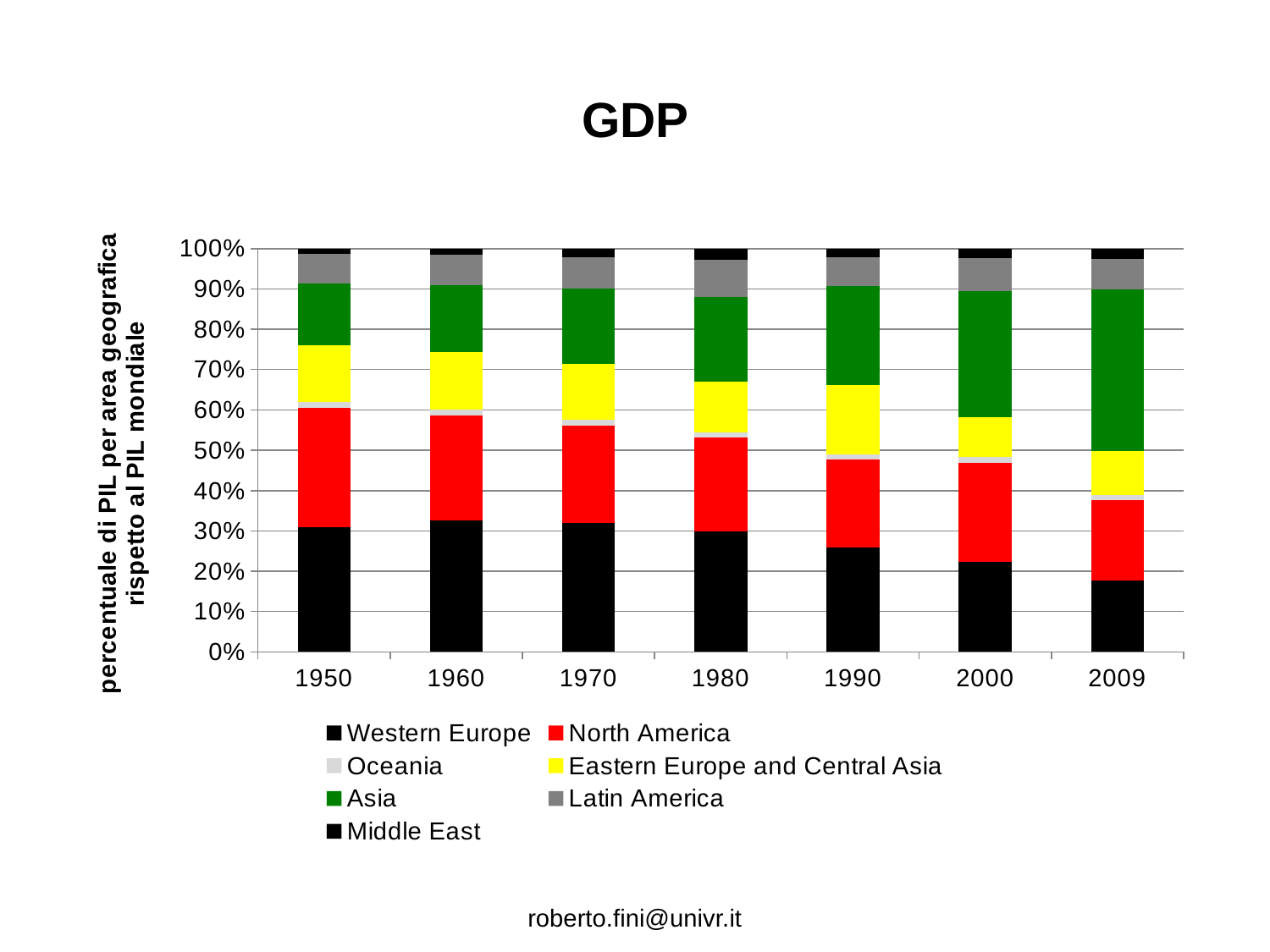
In which year is the Western Europe segment the smallest? 2009 Does the Western Europe share of GDP rise or fall from 1950 to 2009? fall Does the Western Europe segment for 2000 reach above or below 30%? below Which series is shown in green in the legend? Asia Does the Asia share of GDP rise or fall from 1950 to 2009? rise Does the Western Europe segment for 2009 reach above or below 20%? below How many series does the legend list? 7 What kind of chart is shown on the slide? stacked bar chart Does the Western Europe segment for 1990 reach above or below 30%? below What is the title of the chart? GDP How many years are shown along the x axis? 7 In which year is the Asia segment the largest? 2009